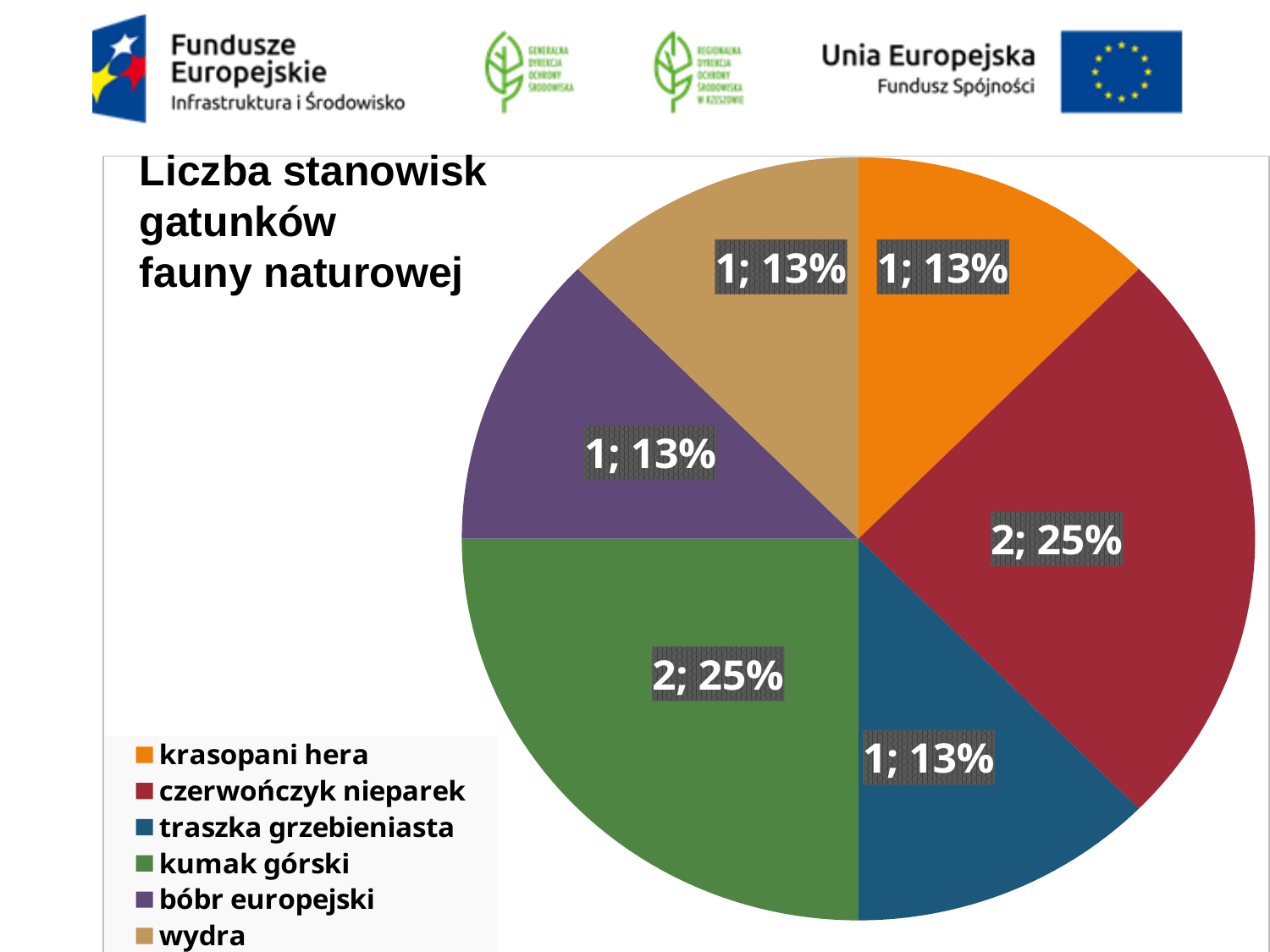
What share of the pie does wydra have? 13% What share of the pie does bóbr europejski have? 13% What kind of chart is shown on the slide? pie chart What is the total of all the values shown in the pie chart? 8 What is the title of the chart? Liczba stanowisk gatunków fauny naturowej What is the difference between the value for kumak górski and the value for wydra? 1 What value is shown for krasopani hera? 1 Which colour represents traszka grzebieniasta in the legend? blue Which is larger, the value for czerwończyk nieparek or the value for traszka grzebieniasta? czerwończyk nieparek What value is shown for czerwończyk nieparek? 2 How many categories does the pie chart have? 6 What share of the pie does kumak górski have? 25%